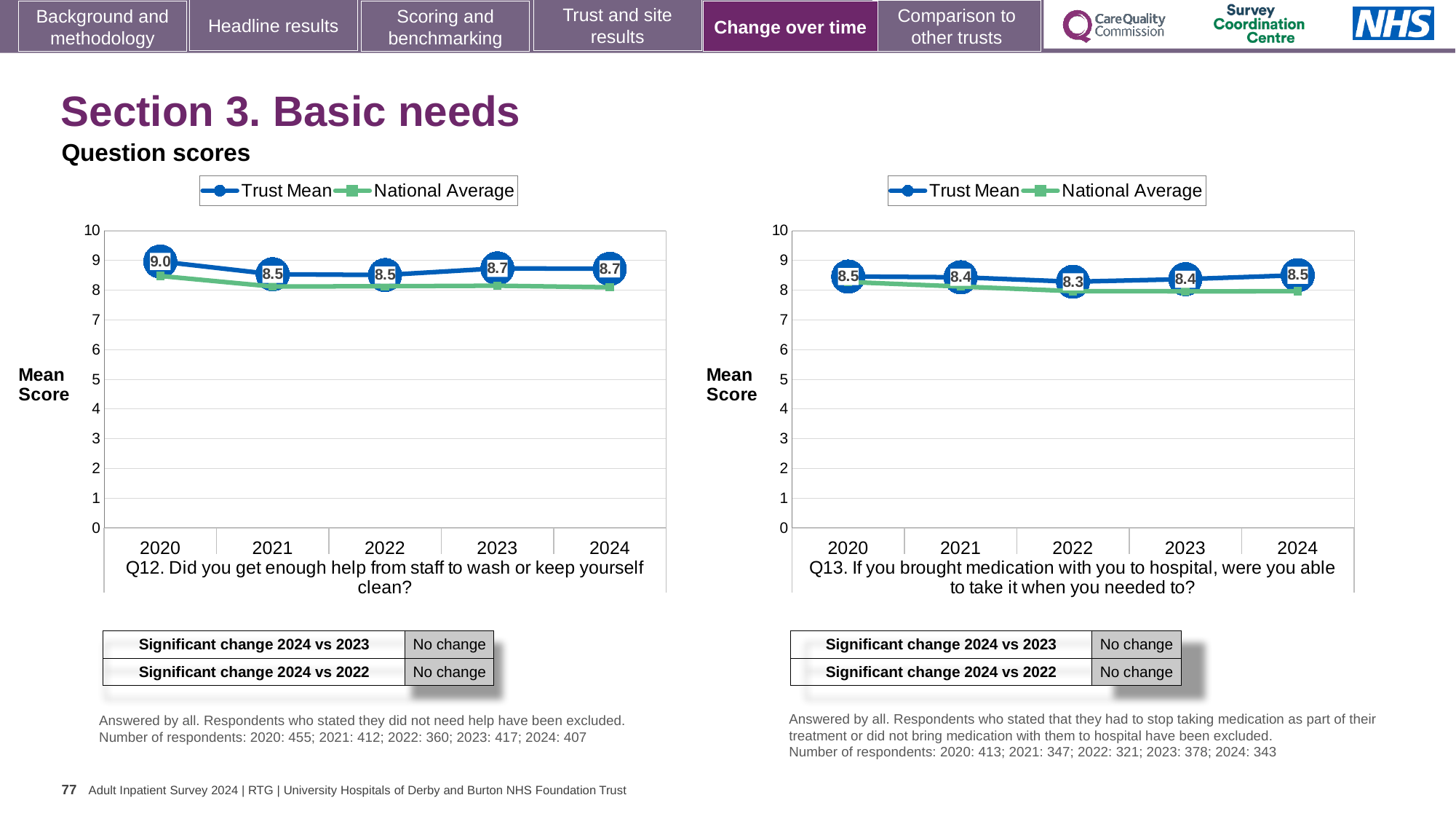
On the Q12 chart (left), what is the difference between the Trust Mean in 2020 and in 2021? 0.5 On the Q12 chart (left), which year has the highest Trust Mean? 2020 What kind of chart is the Q12 chart on the left? line chart On the Q13 chart (right), is the Trust Mean for 2023 larger or smaller than the Trust Mean for 2022? larger On the Q13 chart (right), which year has the lowest Trust Mean? 2022 On the Q12 chart (left), what is the label of the y axis? Mean Score On the Q13 chart (right), what is the Trust Mean for 2022? 8.3 On the Q12 chart (left), what is the Trust Mean for 2020? 9.0 On the Q13 chart (right), is the National Average for 2024 greater or less than 9? less On the Q13 chart (right), how many series does the legend list? 2 On the Q12 chart (left), what is the Trust Mean for 2024? 8.7 On the Q12 chart (left), how many years are shown on the x axis? 5